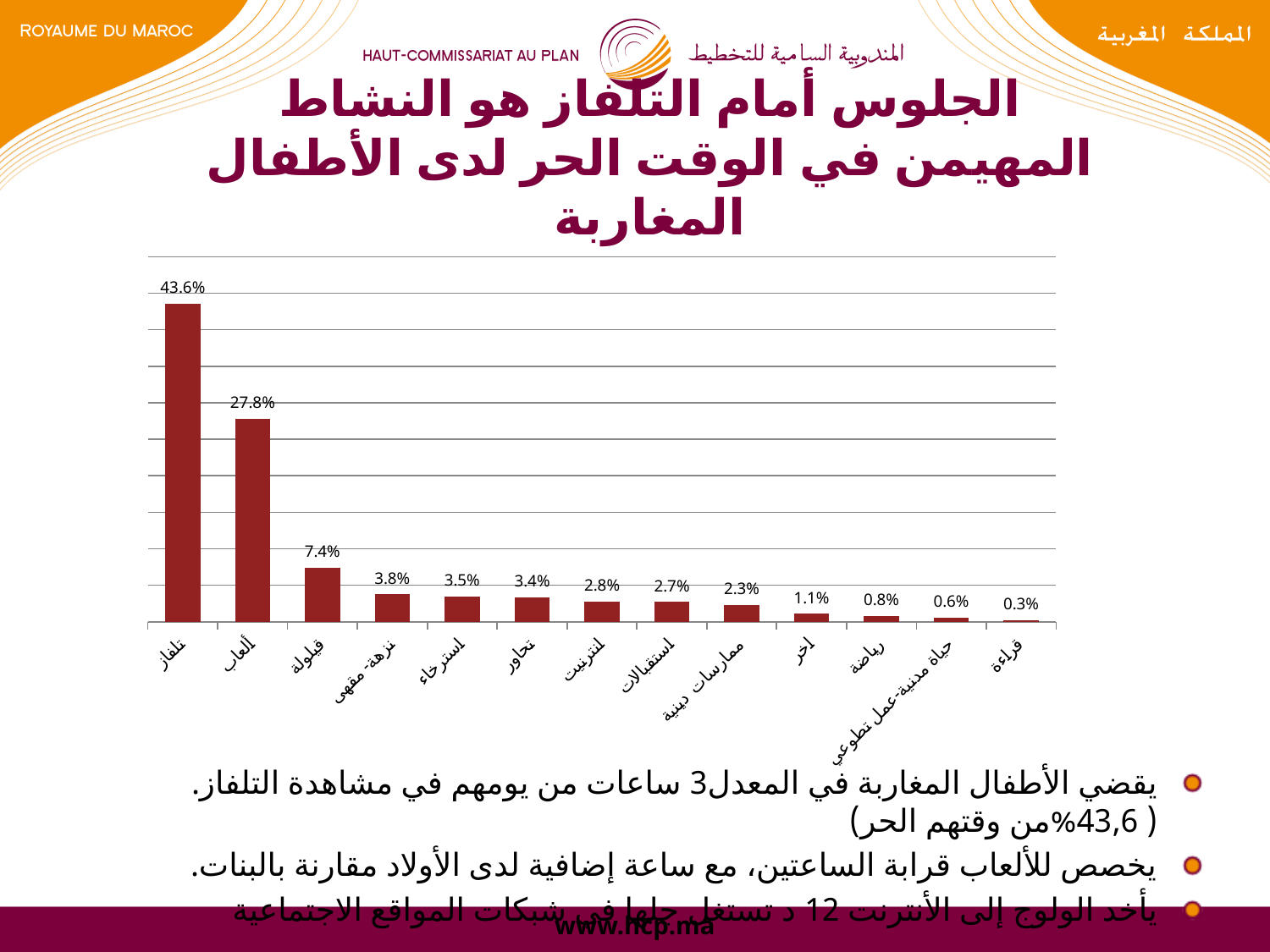
What is the difference between the values for تلفاز and ألعاب? 15.8% What is the value shown for قراءة? 0.3% What is the value shown for قيلولة? 7.4% What kind of chart is shown on the slide? bar chart What is the value shown for ممارسات دينية? 2.3% Do the values rise or fall from left to right along the x axis? fall How many categories are shown on the chart? 13 Which category has the highest value? تلفاز What is the value shown for تلفاز? 43.6% Which category has the lowest value? قراءة What is the value shown for ألعاب? 27.8% Which is larger, the value for رياضة or the value for آخر? اخر